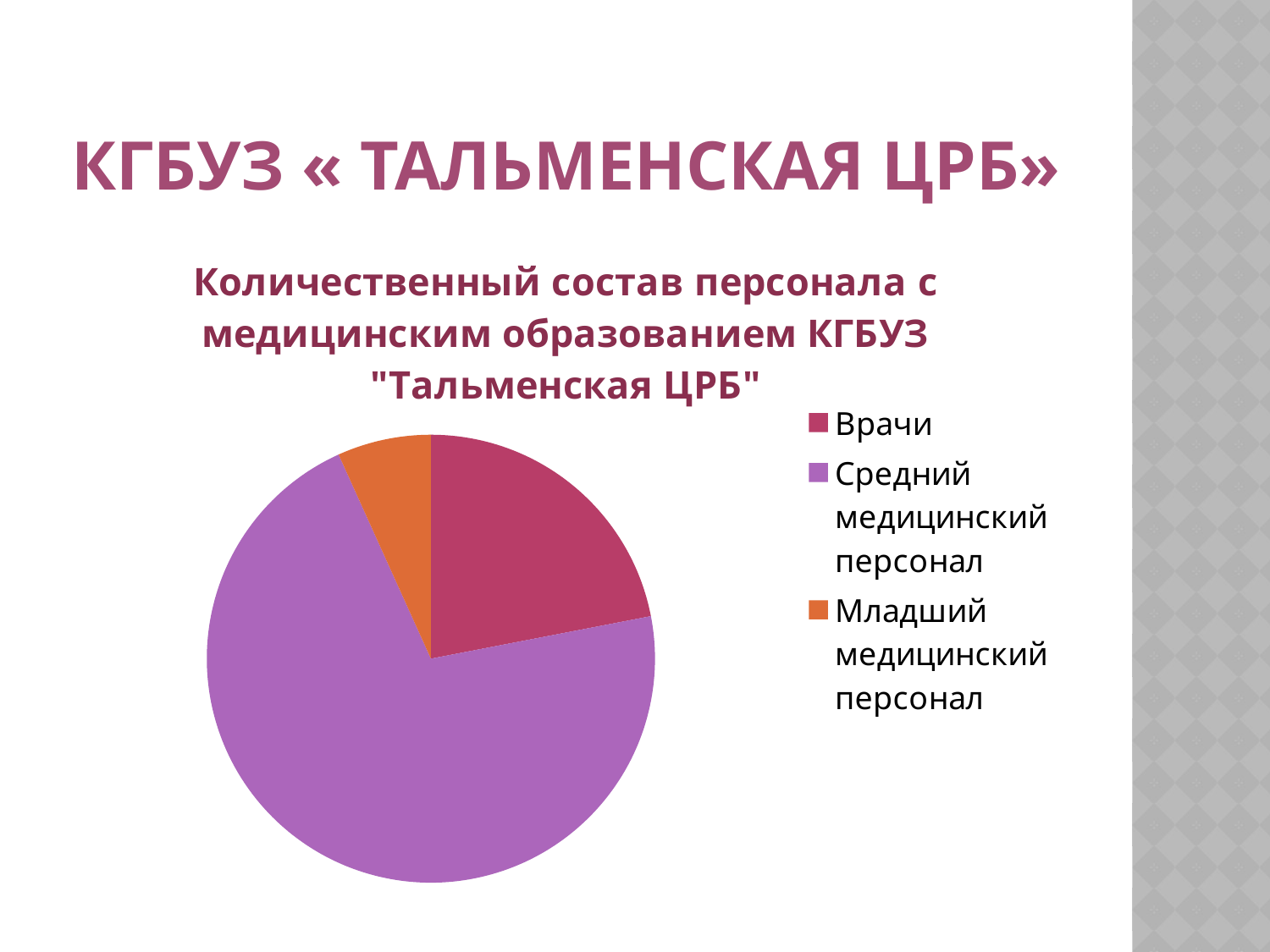
Which category has the largest slice of the pie chart? Средний медицинский персонал Which slice is larger: Врачи or Средний медицинский персонал? Средний медицинский персонал What colour is the slice for Младший медицинский персонал in the pie chart? orange What kind of chart is shown on the slide? pie chart How many entries does the legend of the pie chart list? 3 What is the title of the pie chart? Количественный состав персонала с медицинским образованием КГБУЗ "Тальменская ЦРБ" Which slice is larger: Врачи or Младший медицинский персонал? Врачи How many slices does the pie chart have? 3 Which category has the smallest slice of the pie chart? Младший медицинский персонал